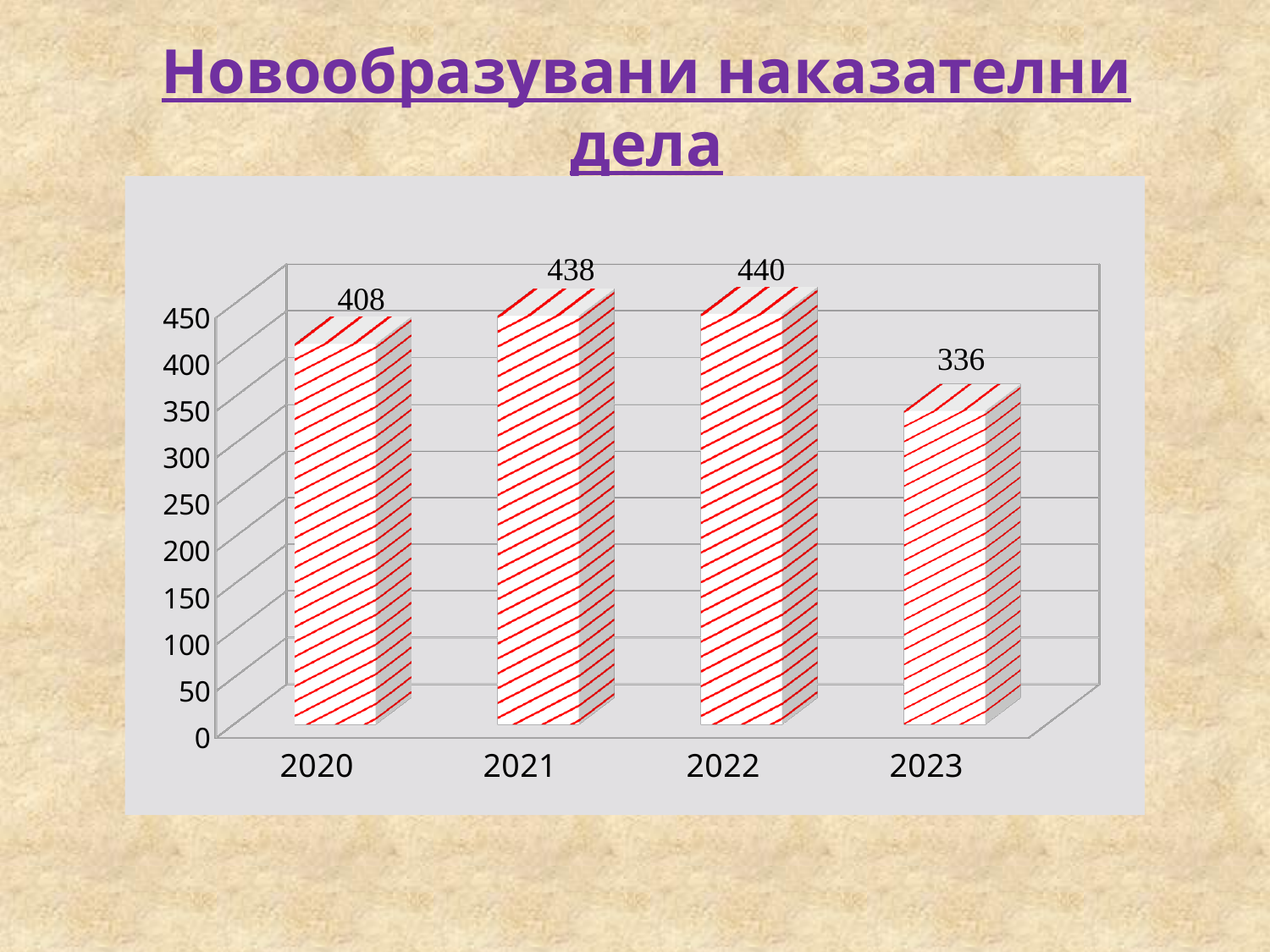
Which year has the highest value? 2022 What is the value for 2023? 336 What is the value for 2021? 438 Which year has the lowest value? 2023 What kind of chart is shown on the slide? bar chart What is the value for 2022? 440 What is the difference between the values for 2021 and 2020? 30 What is the title of the slide? Новообразувани наказателни дела What is the value for 2020? 408 Which is larger, the value for 2020 or the value for 2023? 2020 What is the difference between the values for 2022 and 2023? 104 How many years are shown on the x axis? 4